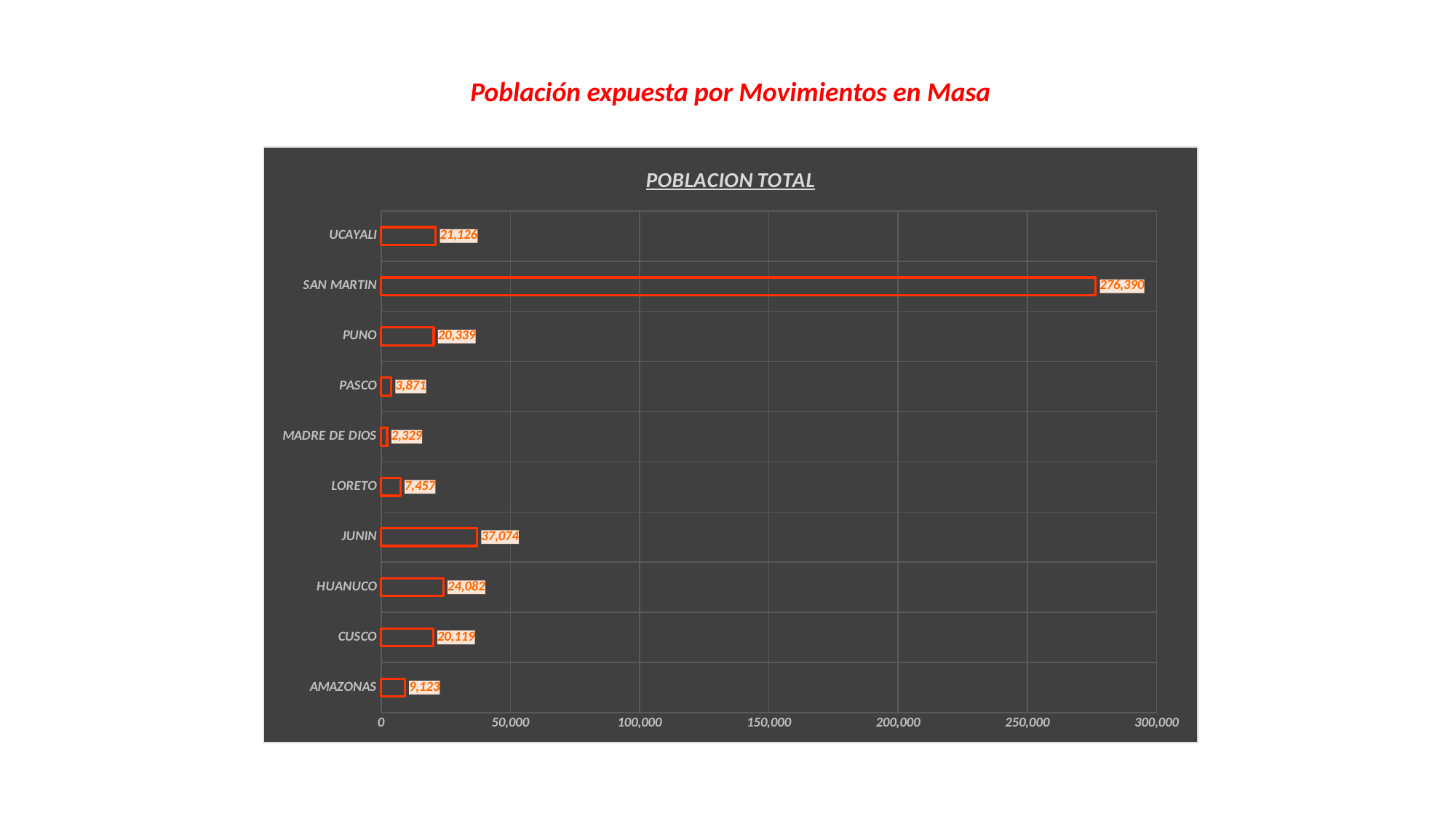
Which category has the lowest value? MADRE DE DIOS Which category has the highest value? SAN MARTIN How many categories are shown in the chart? 10 What kind of chart is shown? bar chart Which is larger, the value for UCAYALI or the value for PUNO? UCAYALI What is the title of the chart? POBLACION TOTAL Is the value for SAN MARTIN greater or less than 250,000? greater What is the value for JUNIN? 37,074 What is the value for AMAZONAS? 9,123 What is the difference between the values for JUNIN and HUANUCO? 12,992 What is the value for MADRE DE DIOS? 2,329 What is the value for SAN MARTIN? 276,390